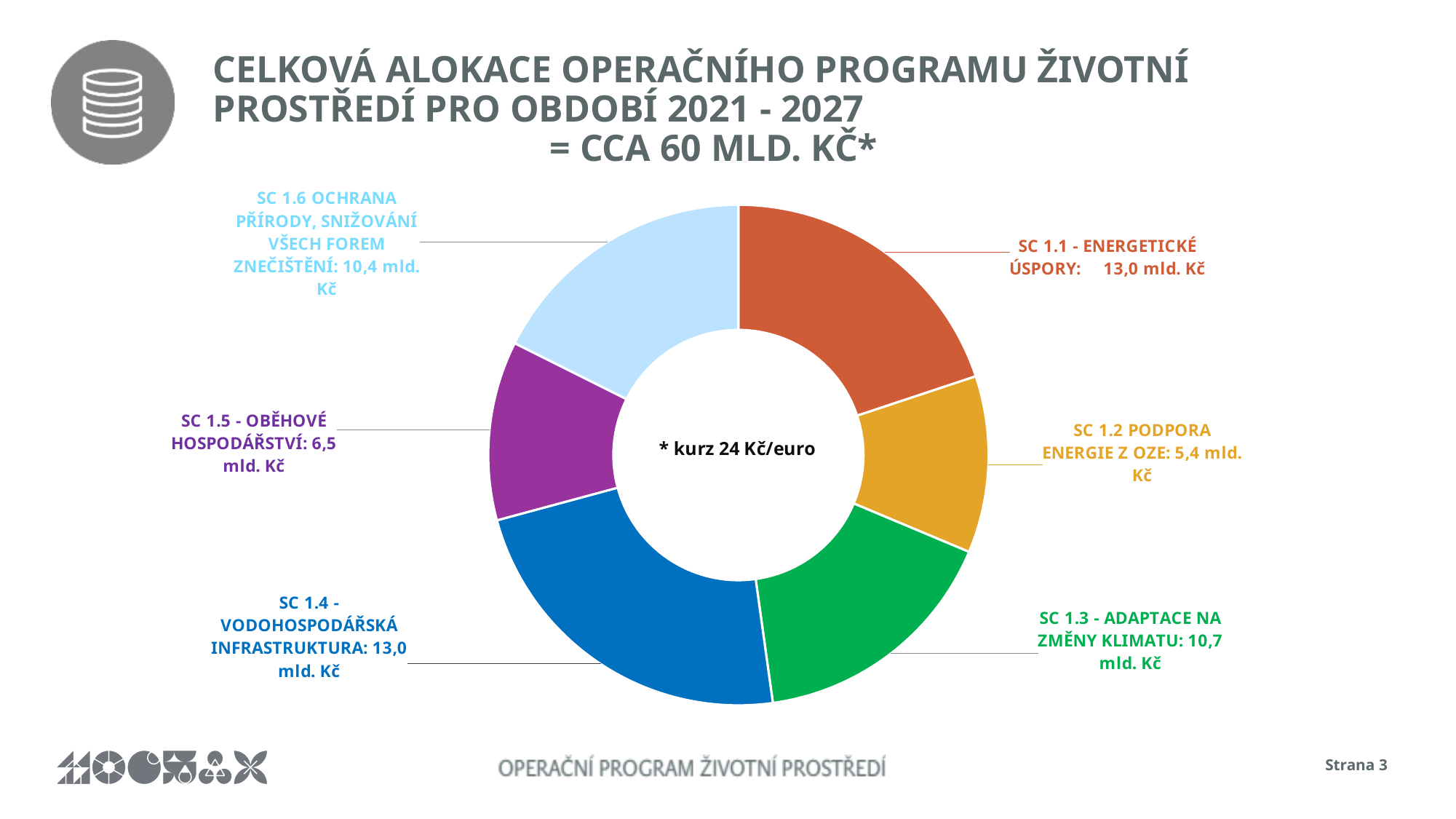
What is the allocation for SC 1.5 - Oběhové hospodářství? 6,5 mld. Kč What is the allocation for SC 1.2 Podpora energie z OZE? 5,4 mld. Kč What is the difference between the allocations for SC 1.4 - Vodohospodářská infrastruktura and SC 1.5 - Oběhové hospodářství? 6,5 mld. Kč What is the allocation for SC 1.6 Ochrana přírody, snižování všech forem znečištění? 10,4 mld. Kč How many segments (specific objectives) does the doughnut chart have? 6 What text is shown in the centre of the doughnut chart? * kurz 24 Kč/euro What is the difference between the allocations for SC 1.1 - Energetické úspory and SC 1.2 Podpora energie z OZE? 7,6 mld. Kč What is the allocation for SC 1.1 - Energetické úspory? 13,0 mld. Kč Which specific objective has the smallest allocation? SC 1.2 Podpora energie z OZE Which has the larger allocation, SC 1.5 - Oběhové hospodářství or SC 1.2 Podpora energie z OZE? SC 1.5 - Oběhové hospodářství What is the allocation for SC 1.3 - Adaptace na změny klimatu? 10,7 mld. Kč What type of chart is shown on the slide? Doughnut (pie) chart